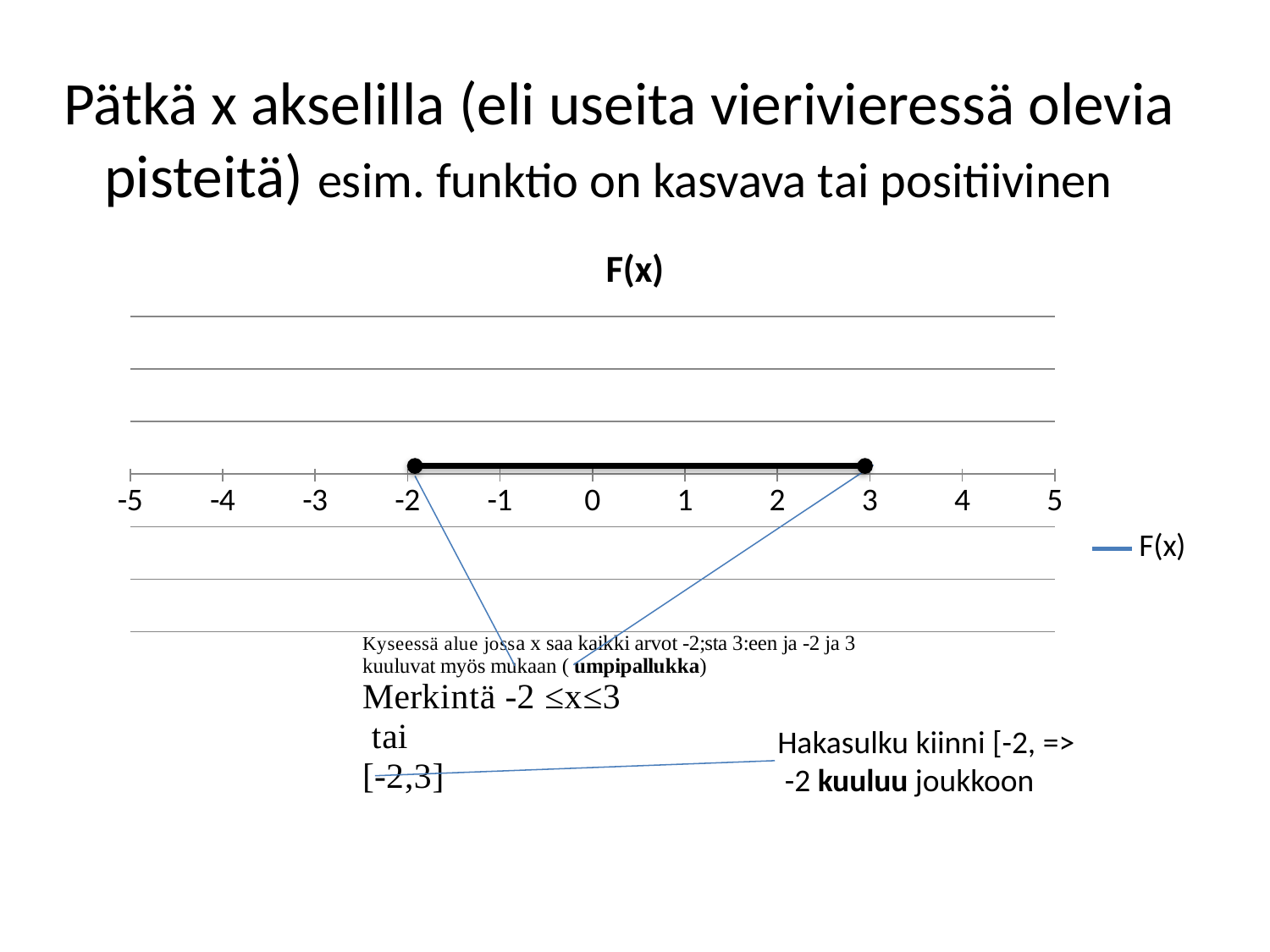
What is the title of the chart? F(x) What is the highest value labelled on the x axis? 5 Does the plotted segment rise, fall, or stay flat as x increases from -2 to 3? stays flat How many tick labels are shown on the x axis? 11 At which x-axis value does the right end of the plotted segment lie? 3 How many endpoint markers are drawn on the plotted segment? 2 How many series does the chart legend list? 1 What is the difference between the x values of the right and left endpoints of the segment? 5 What is the lowest value labelled on the x axis? -5 What is the name of the series shown in the legend? F(x) At which x-axis value does the left end of the plotted segment lie? -2 What kind of chart is shown on the slide? line chart